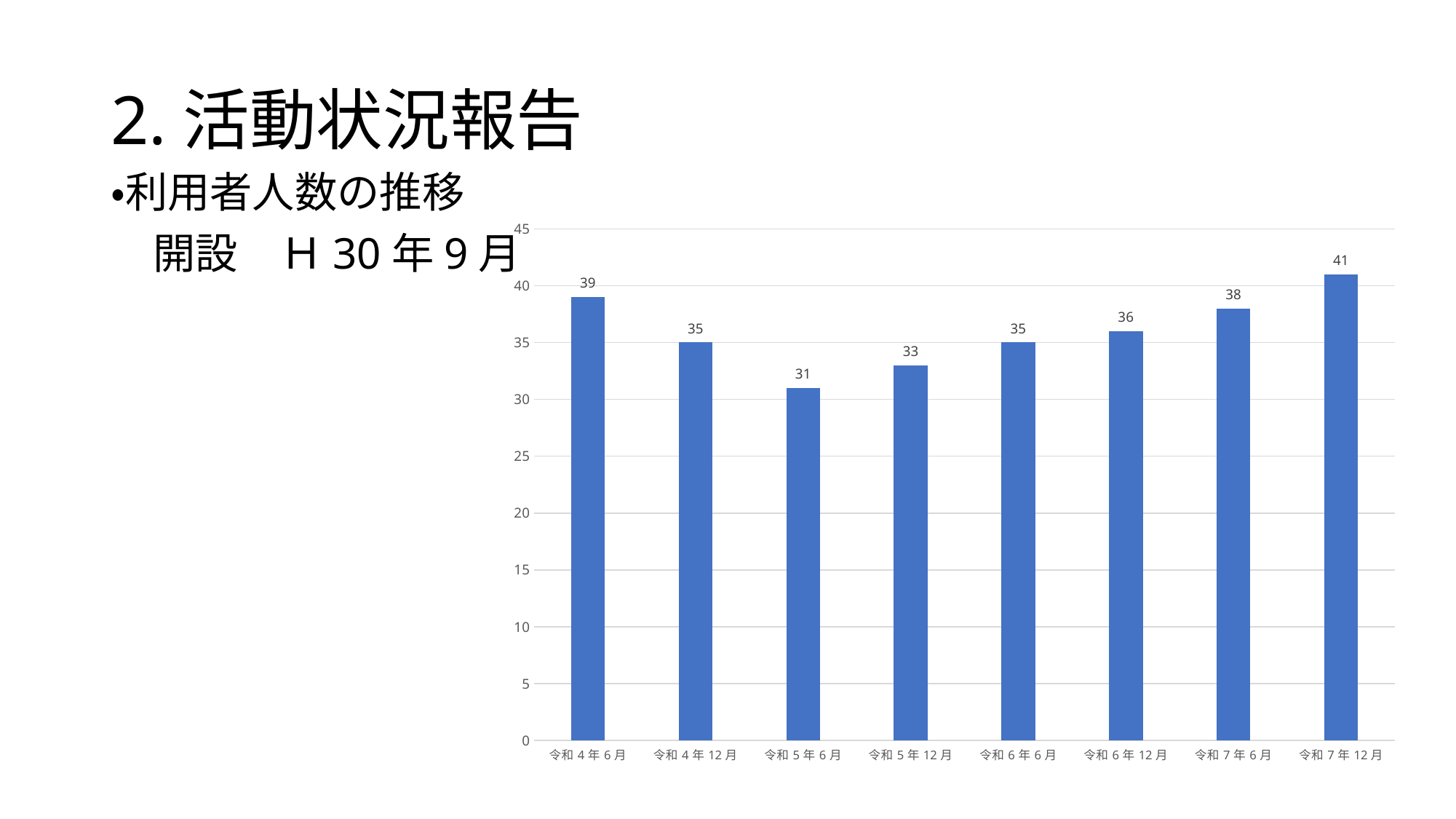
What kind of chart is shown on the slide? bar chart What is the value for 令和5年6月? 31 Do the values rise or fall from 令和5年6月 to 令和7年12月? rise Which category has the lowest value? 令和5年6月 Is the value for 令和5年12月 greater or less than 35? less How many bars are shown in the chart? 8 Which category has the highest value? 令和7年12月 What is the difference between the values for 令和7年12月 and 令和5年6月? 10 What is the value for 令和6年12月? 36 What is the value for 令和7年12月? 41 Which is larger, the value for 令和4年6月 or the value for 令和7年6月? 令和4年6月 What is the value for 令和4年6月? 39